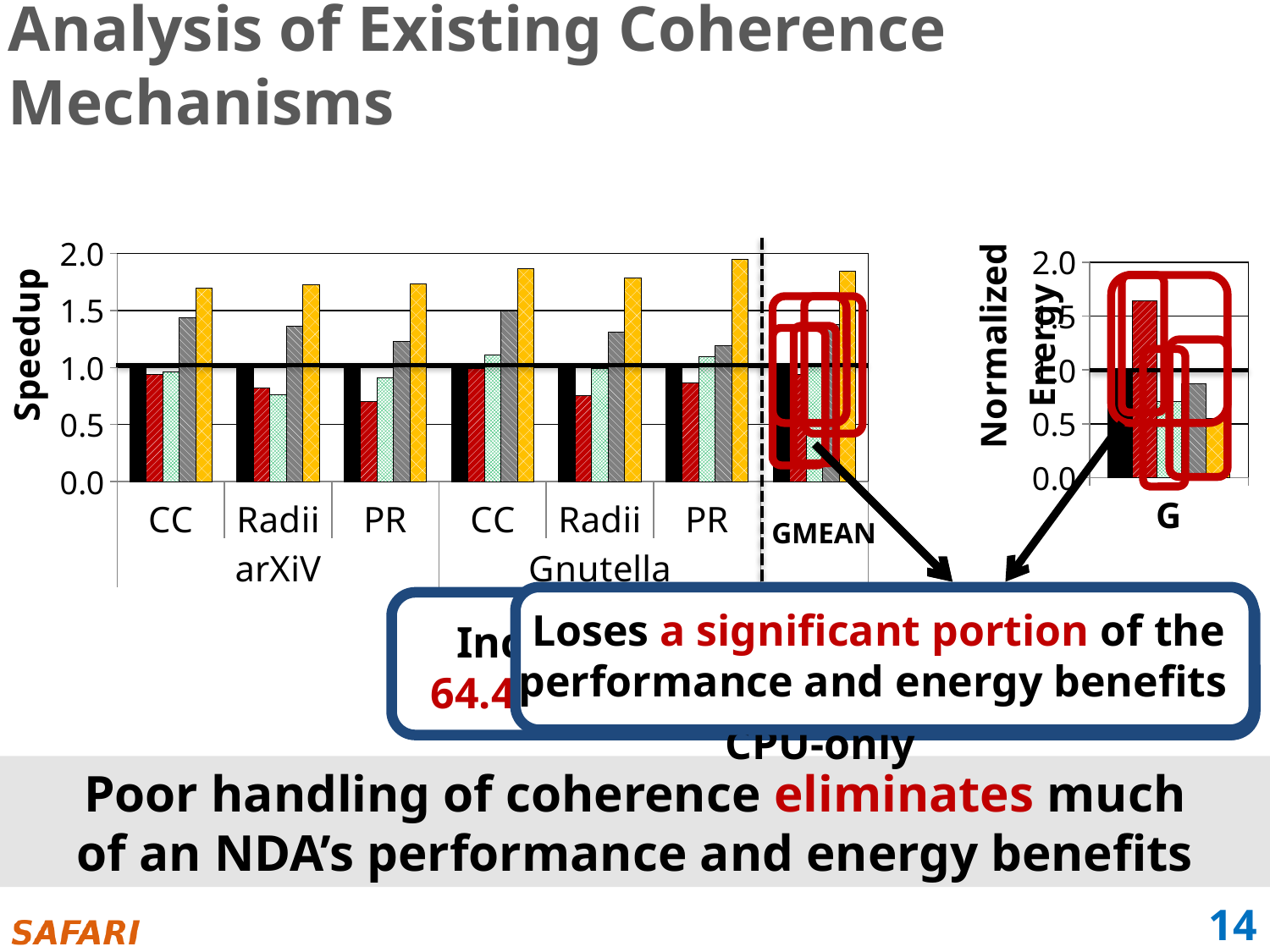
In the Normalized Energy chart, is the value of the red hatched bar greater or less than 1.5? greater In the Speedup chart, is the value of the yellow bar for CC under arXiV greater or less than 1.5? greater In the Speedup chart, is the value of the red hatched bar for PR under arXiV greater or less than 1.0? less What type of chart is the Speedup chart on the left? bar chart In the Speedup chart, which two workloads are the benchmark categories grouped under? arXiV and Gnutella In the Speedup chart, for CC under arXiV, which is larger: the yellow bar or the red hatched bar? the yellow bar In the Speedup chart, which is larger: the red hatched bar for Radii under arXiV or the red hatched bar for CC under Gnutella? CC under Gnutella What is the y-axis label of the chart on the right? Normalized Energy In the Speedup chart, how many category groups are shown along the x axis (including GMEAN)? 7